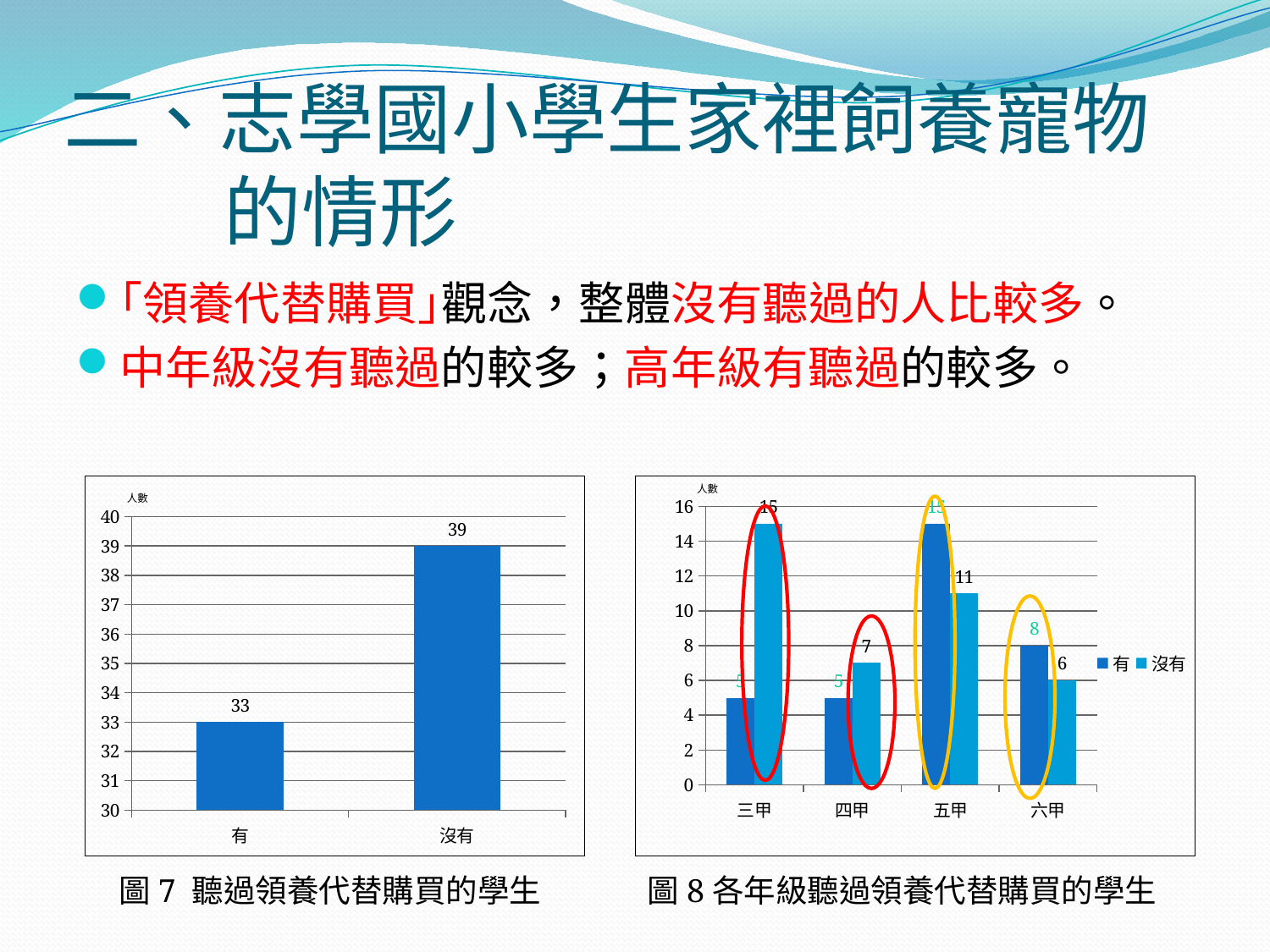
In the right chart (圖 8), what is the value of 有 for 六甲? 8 In the left chart (圖 7), what is the value for 有? 33 In the right chart (圖 8), for 五甲, which is larger, 有 or 沒有? 有 In the right chart (圖 8), how many classes are shown on the x axis? 4 In the left chart (圖 7), what is the value for 沒有? 39 In the right chart (圖 8), which class has the lowest value for 沒有? 六甲 In the left chart (圖 7), what kind of chart is shown? bar chart In the right chart (圖 8), what is the value of 沒有 for 三甲? 15 In the left chart (圖 7), what is the difference between 沒有 and 有? 6 In the right chart (圖 8), how many series does the legend list? 2 In the right chart (圖 8), which class has the highest value for 有? 五甲 In the right chart (圖 8), what is the value of 沒有 for 四甲? 7